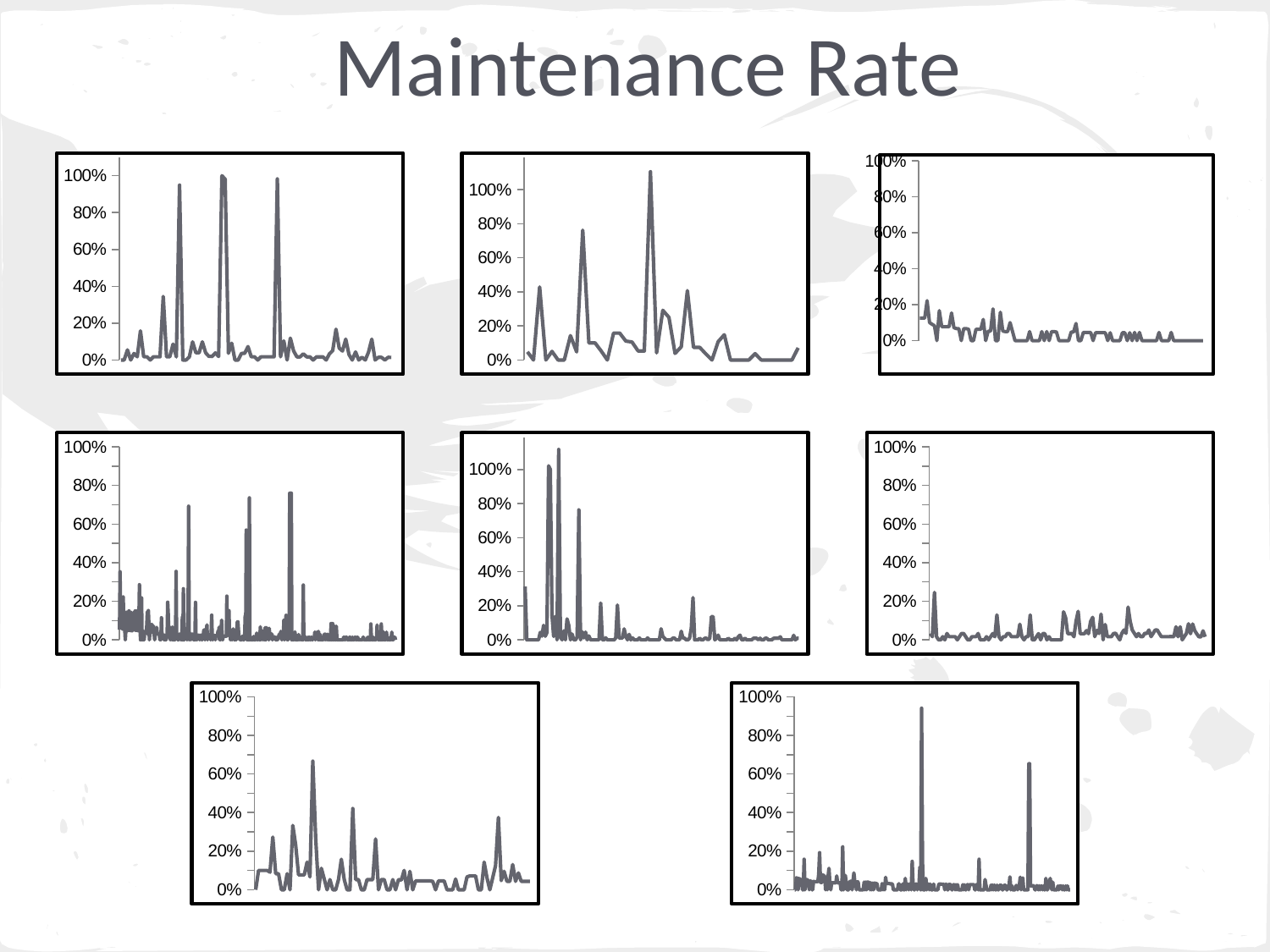
In the top-middle chart, is the highest peak greater or less than 100%? greater What is the lowest tick label on the y axis of the bottom-right chart? 0% In the top-right chart, is the highest value greater or less than 40%? less How many charts are shown on the slide? 8 What kind of chart is the top-left chart on the slide? line chart In the bottom-right chart, is the highest peak greater or less than 80%? greater How many charts are in the bottom row of the slide? 2 What is the title of the slide containing the charts? Maintenance Rate